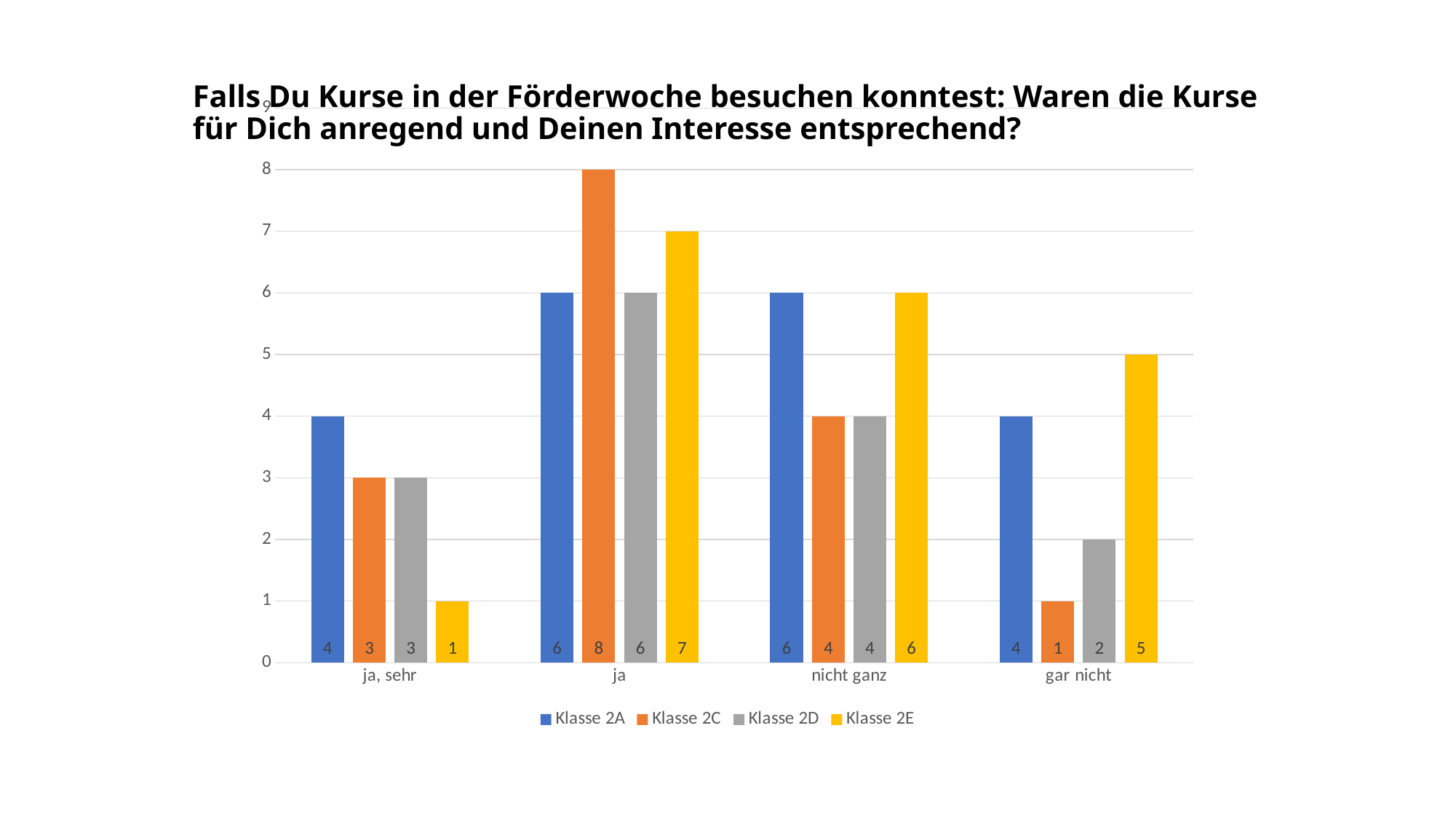
Which colour represents Klasse 2E in the chart? Yellow What is the value for Klasse 2D in the "gar nicht" category? 2 Which series has the lowest value in the "gar nicht" category? Klasse 2C What is the total of the four series in the "ja" category? 27 How many categories are shown on the x axis? 4 Which series has the highest value in the "ja" category? Klasse 2C What kind of chart is shown on the slide? Bar chart Which is larger: Klasse 2A in "nicht ganz" or Klasse 2A in "gar nicht"? Klasse 2A in "nicht ganz" How many series does the legend list? 4 What is the value for Klasse 2C in the "ja" category? 8 What is the value for Klasse 2E in the "ja, sehr" category? 1 What is the difference between Klasse 2E and Klasse 2C in the "gar nicht" category? 4